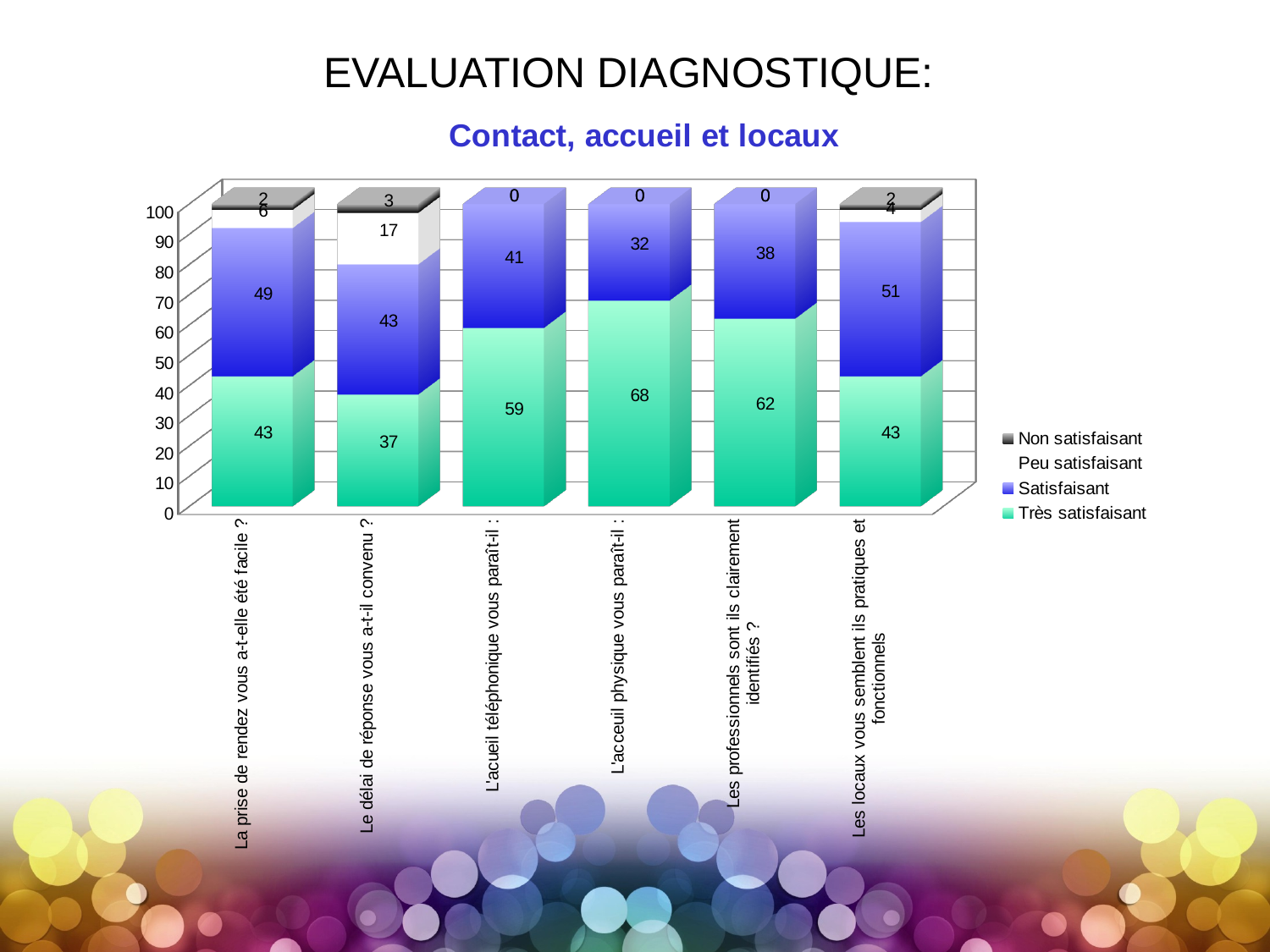
What kind of chart is shown on the slide? Stacked bar chart What is the difference between the 'Très satisfaisant' values for 'L'acceuil physique vous paraît-il :' and 'L'accueil téléphonique vous paraît-il :'? 9 What is the total of the stacked bar for 'Le délai de réponse vous a-t-il convenu ?'? 100 What is the 'Satisfaisant' value for 'Les locaux vous semblent ils pratiques et fonctionnels'? 51 How many series does the legend list? 4 Which category has the highest 'Très satisfaisant' value? L'acceuil physique vous paraît-il : What is the 'Peu satisfaisant' value for 'Le délai de réponse vous a-t-il convenu ?'? 17 What is the subtitle of the chart shown on the slide? Contact, accueil et locaux How many categories (questions) are shown on the x axis? 6 Which is larger: the 'Satisfaisant' value for 'La prise de rendez vous a-t-elle été facile ?' or for 'Les professionnels sont ils clairement identifiés ?'? La prise de rendez vous a-t-elle été facile ? What is the 'Très satisfaisant' value for 'L'acceuil physique vous paraît-il :'? 68 Which category has the lowest 'Très satisfaisant' value? Le délai de réponse vous a-t-il convenu ?